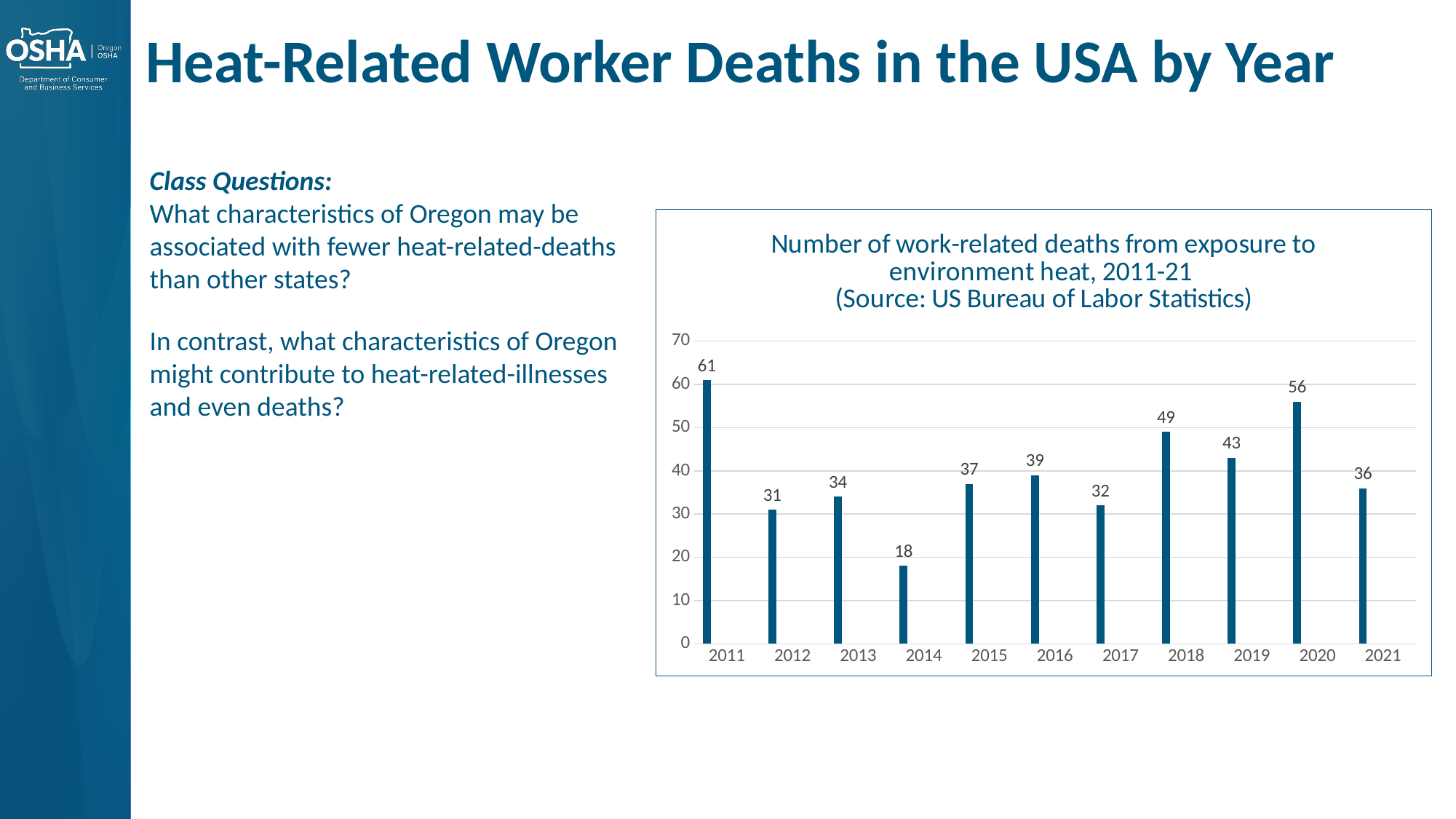
Which year has the lowest number of work-related heat deaths? 2014 What is the difference between the values for 2011 and 2014? 43 Is the value for 2020 greater or less than 50? greater What is the difference between the values for 2018 and 2019? 6 Which year has the highest number of work-related heat deaths? 2011 What is the value shown for 2020? 56 What is the value shown for 2014? 18 Which year has a larger value, 2016 or 2017? 2016 How many years are shown on the x axis of the chart? 11 What source is cited in the chart title? US Bureau of Labor Statistics What is the number of work-related deaths from exposure to environmental heat in 2011? 61 What kind of chart is shown on the slide? Bar chart